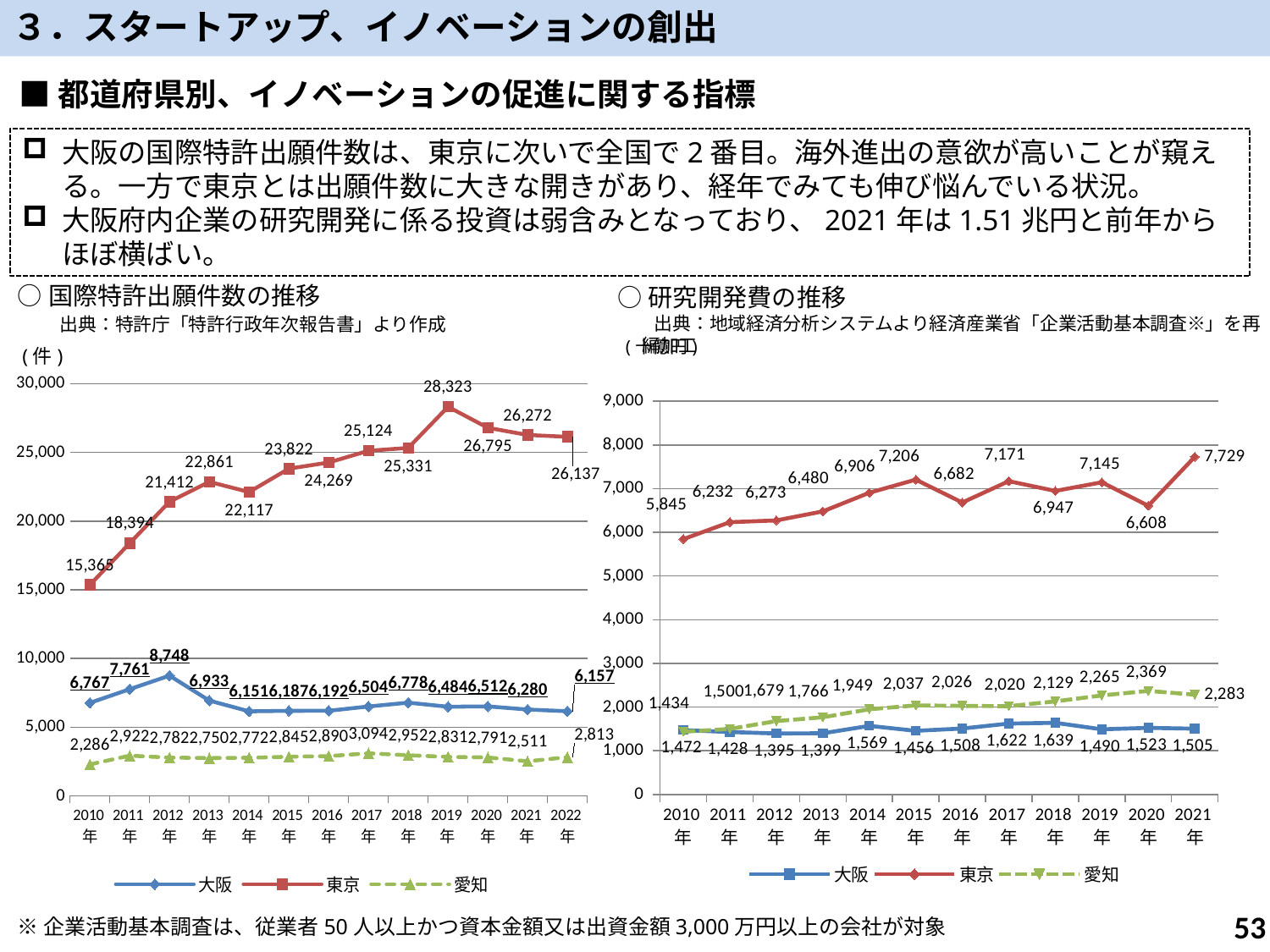
In the left chart (国際特許出願件数の推移), what is the difference between 東京 and 大阪 in 2022? 19,980 In the right chart (研究開発費の推移), what is the difference between 東京 in 2021 and 東京 in 2020? 1,121 In the left chart (国際特許出願件数の推移), how many years are shown on the x axis? 13 In the right chart (研究開発費の推移), what is the value for 愛知 in 2020? 2,369 In the left chart (国際特許出願件数の推移), what is the value for 東京 in 2019? 28,323 In the left chart (国際特許出願件数の推移), how many series does the legend list? 3 In the left chart (国際特許出願件数の推移), what is the value for 大阪 in 2012? 8,748 In the right chart (研究開発費の推移), in which year does 大阪 have its lowest value? 2012年 In the left chart (国際特許出願件数の推移), in which year does 東京 reach its highest value? 2019年 In the right chart (研究開発費の推移), which is larger in 2021, 大阪 or 愛知? 愛知 What kind of chart is the right chart (研究開発費の推移)? Line chart In the right chart (研究開発費の推移), what is the value for 東京 in 2021? 7,729